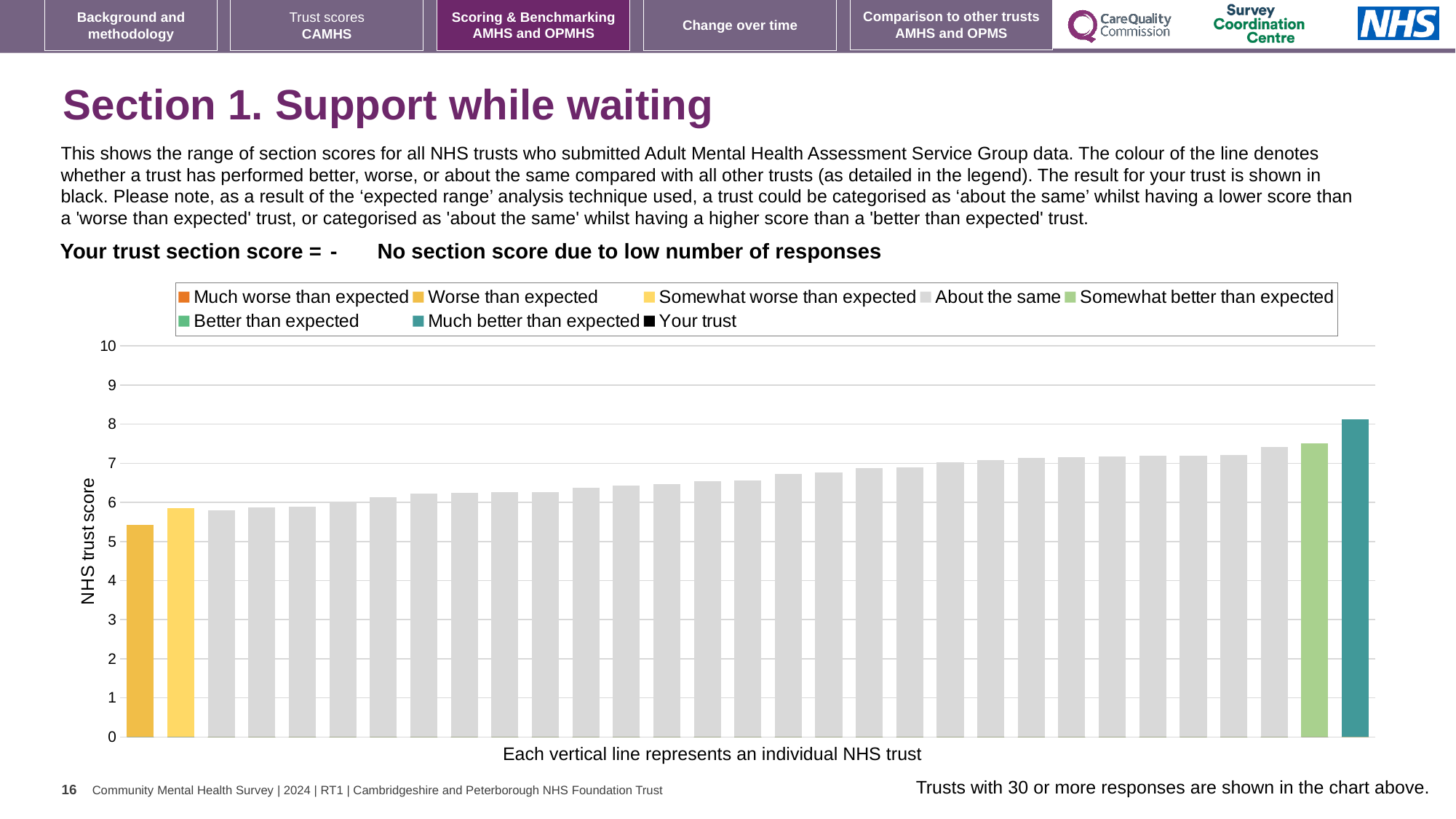
Which is larger: the leftmost bar or the rightmost bar? The rightmost bar Is the value of the tallest bar in the chart greater or less than 7? greater Is the value of the second bar from the left greater or less than 5? greater What is the maximum value shown on the vertical axis of the chart? 10 Which legend category does the shortest bar in the chart belong to? Worse than expected Do the bar values rise or fall from left to right across the chart? Rise What kind of chart is shown on the slide? Bar chart How many bars in the chart are coloured as 'Somewhat better than expected'? 1 Which legend category does the tallest bar in the chart belong to? Much better than expected What is the label on the vertical axis of the chart? NHS trust score Is the value of the shortest bar in the chart greater or less than 6? less How many entries does the chart legend list? 8